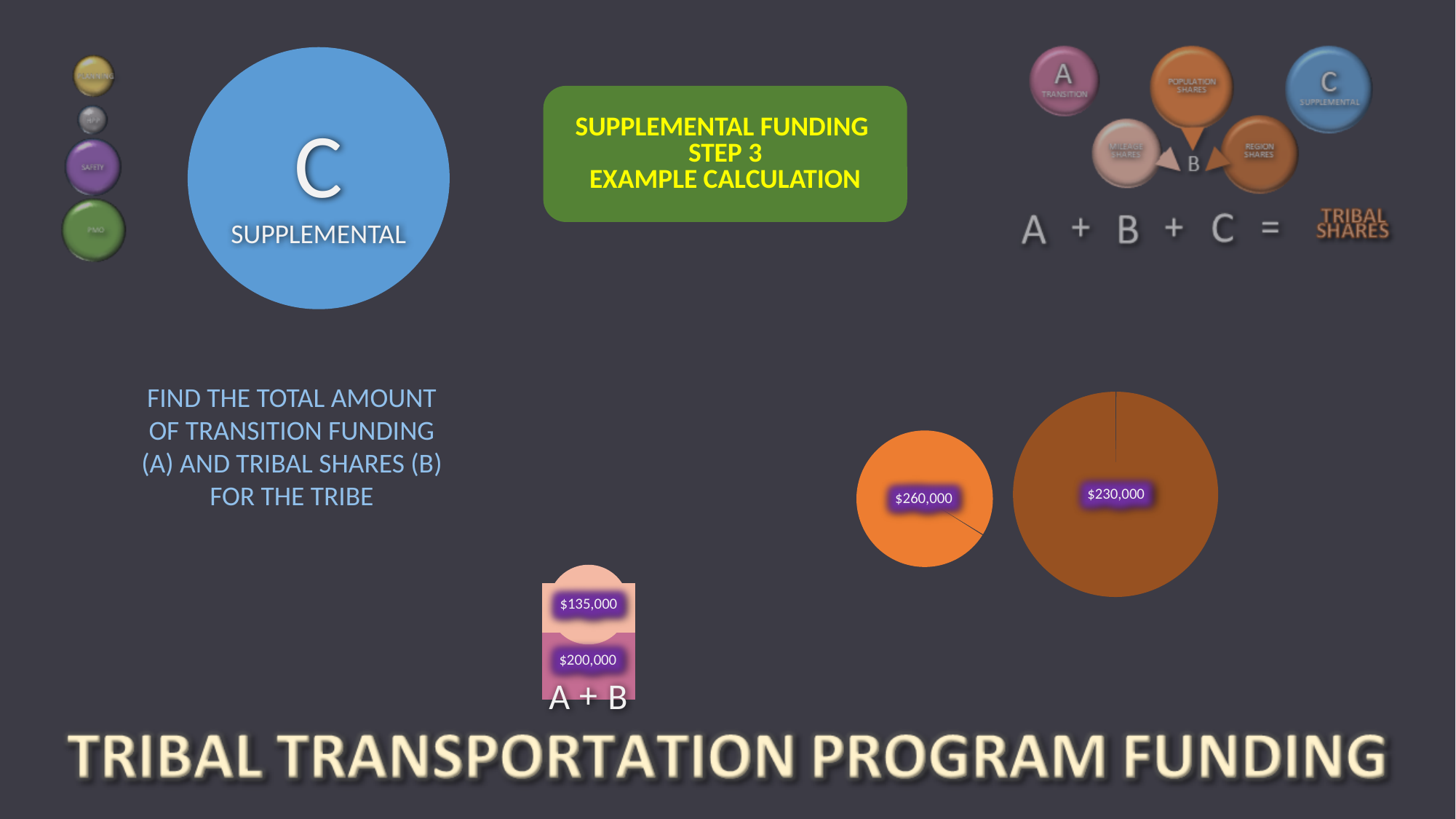
Which of the two pie charts on the right shows the larger printed value, the orange one or the brown one? The orange one What label appears directly below the stacked bar at the bottom centre of the slide? A + B What value is printed on the orange pie chart on the right side of the slide? $260,000 In the stacked bar labeled "A + B", what value is printed on the bottom (pink) segment? $200,000 In the stacked bar labeled "A + B", what value is printed on the top (peach) segment? $135,000 In the stacked bar labeled "A + B", which segment is larger, the $135,000 segment or the $200,000 segment? The $200,000 segment What value is printed on the brown pie chart on the right side of the slide? $230,000 What kind of chart is the "A + B" graphic at the bottom centre of the slide? Stacked bar chart In the stacked bar labeled "A + B", what is the total of the two segments? $335,000 In the stacked bar labeled "A + B", what is the difference between the two segment values? $65,000 What is the difference between the value printed on the orange pie chart and the value printed on the brown pie chart? $30,000 How many segments make up the stacked bar labeled "A + B"? 2